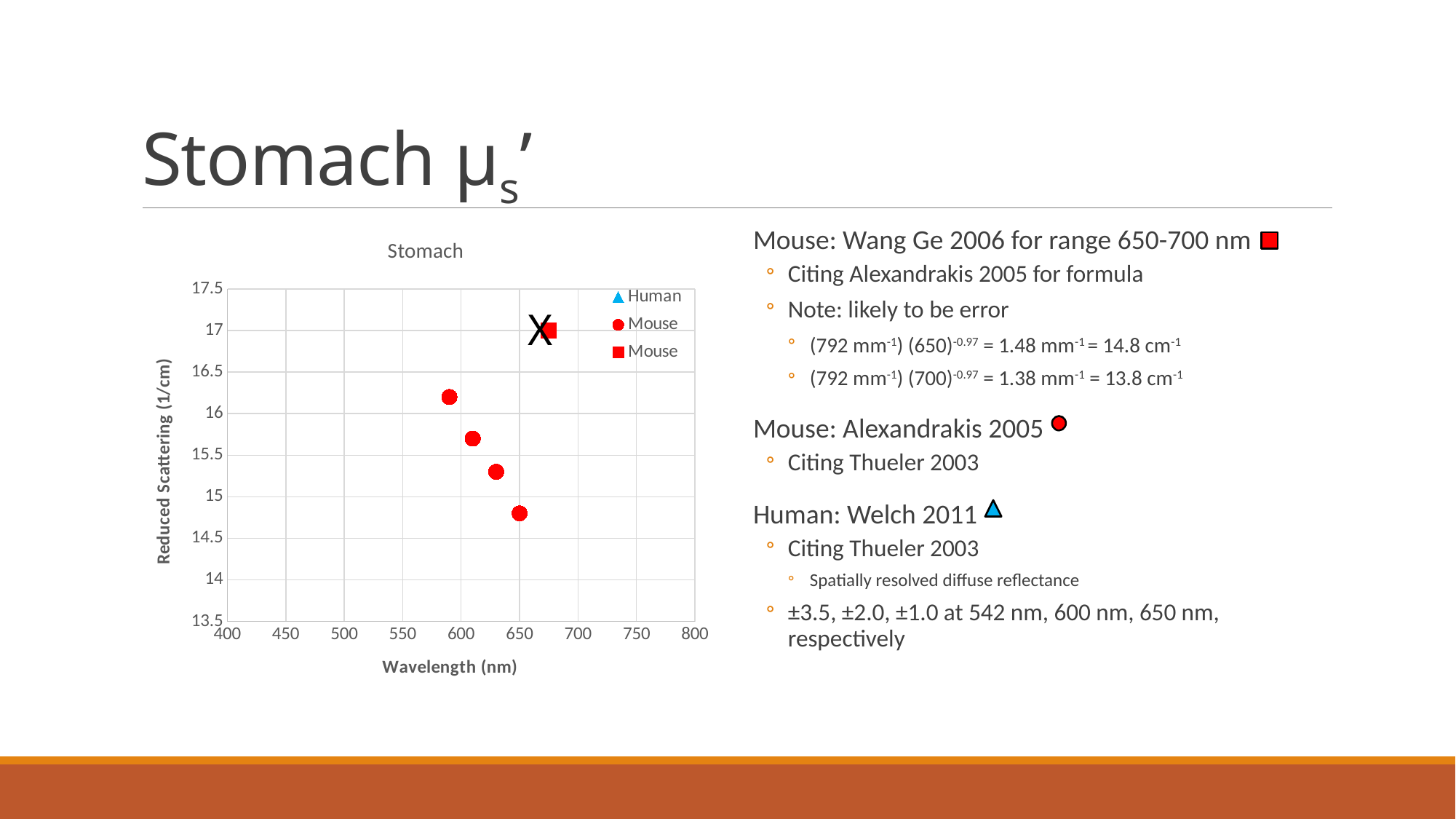
How many series does the chart legend list? 3 Which plotted point has the highest reduced scattering value on the chart? the red square (Mouse) point near 675 nm Is the reduced scattering value of the red circle point near 650 nm greater or less than 15? less Is the reduced scattering value of the red circle point near 590 nm greater or less than 16? greater What is the title of the chart? Stomach How many red circle (Mouse) points are plotted on the chart? 4 Which has a higher reduced scattering value: the red square point or the red circle point near 650 nm? the red square point Do the red circle (Mouse) values rise or fall as wavelength increases? fall What kind of chart is shown on the slide? scatter chart Is the reduced scattering value of the red square (Mouse) point greater or less than 16.5? greater Which plotted point has the lowest reduced scattering value on the chart? the red circle (Mouse) point near 650 nm What is the label of the y axis of the chart? Reduced Scattering (1/cm)